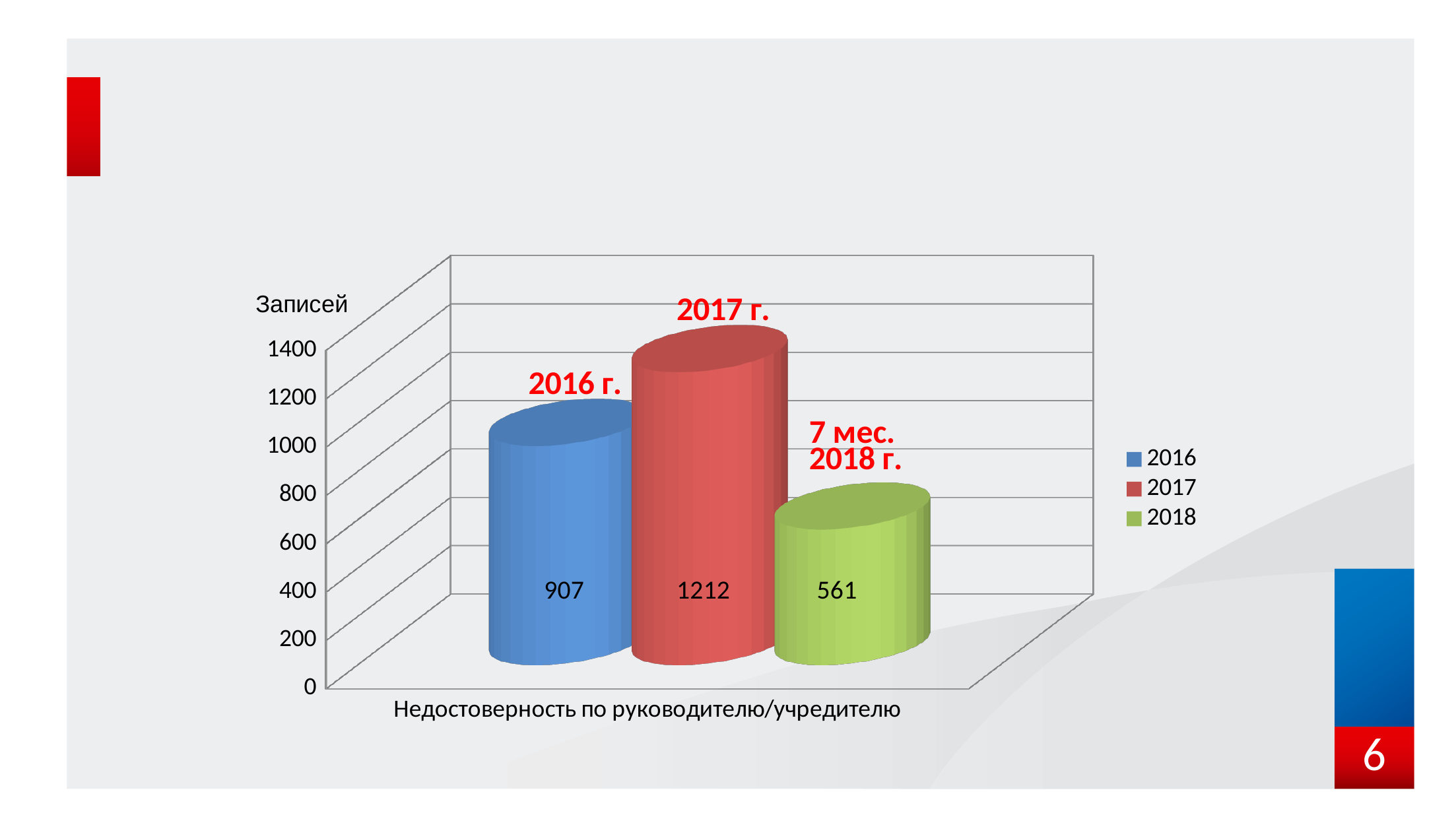
Which year has the lowest value? 2018 Which year has the highest value? 2017 How many series does the legend list? 3 What is the value for 2016 in the chart? 907 What kind of chart is shown on the slide? bar chart What is the difference between the values for 2016 and 2018? 346 What is the value for 2018 in the chart? 561 Is the value for 2017 greater or less than 1000? greater What is the value for 2017 in the chart? 1212 What is the difference between the values for 2017 and 2016? 305 Which is larger, the value for 2016 or the value for 2018? 2016 What is the label on the x axis of the chart? Недостоверность по руководителю/учредителю